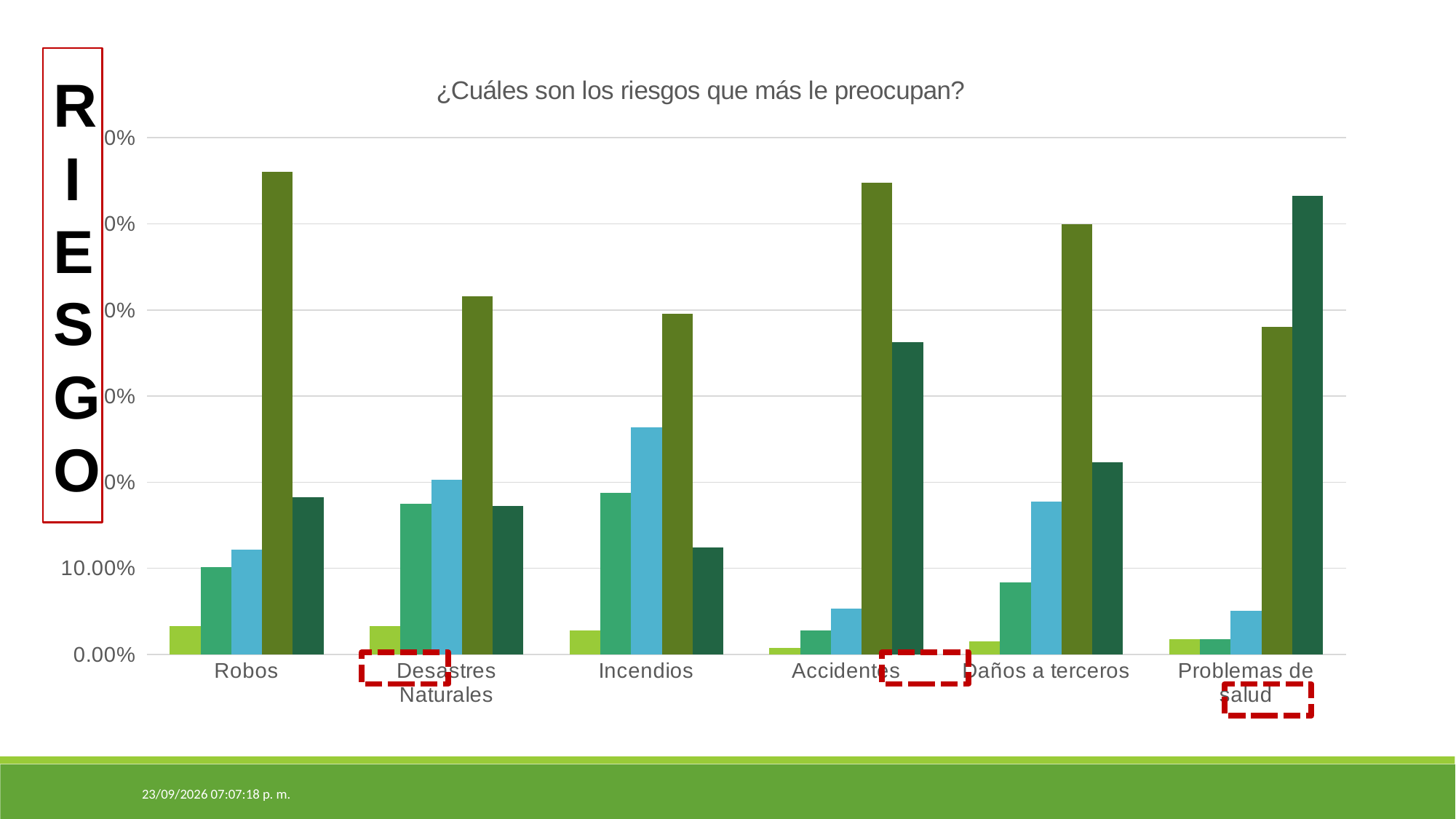
What kind of chart is shown on the slide? bar chart For Problemas de salud, which is larger: the olive green bar or the dark green bar? the dark green bar Is the value of the dark green bar for Problemas de salud greater or less than 50%? greater Is the value of the dark green bar for Accidentes greater or less than 30%? greater Is the value of the olive green bar for Robos greater or less than 50%? greater Which category has the tallest dark green bar? Problemas de salud How many categories are shown on the x axis of the chart? 6 What is the title of the chart? ¿Cuáles son los riesgos que más le preocupan? How many bars are plotted for each category in the chart? 5